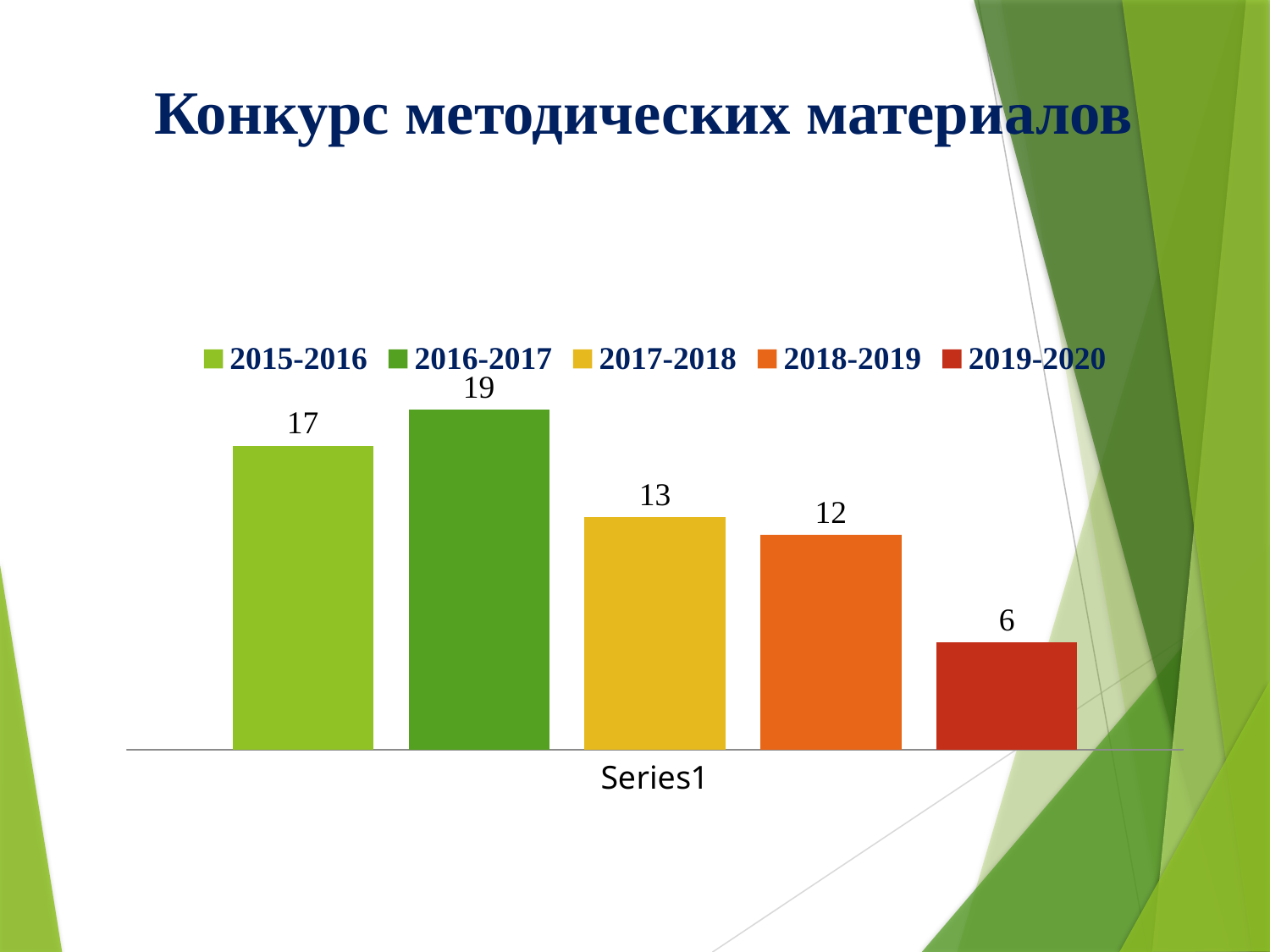
Which period has the lowest value? 2019-2020 What kind of chart is shown on the slide? bar chart What is the value for 2017-2018? 13 Which period has the highest value? 2016-2017 How many entries does the legend list? 5 What is the difference between the values for 2015-2016 and 2018-2019? 5 What is the difference between the values for 2016-2017 and 2019-2020? 13 Which is larger, the value for 2017-2018 or the value for 2018-2019? 2017-2018 What is the value for 2019-2020? 6 How many bars are shown in the chart? 5 What is the value for 2015-2016? 17 What is the title of the slide? Конкурс методических материалов